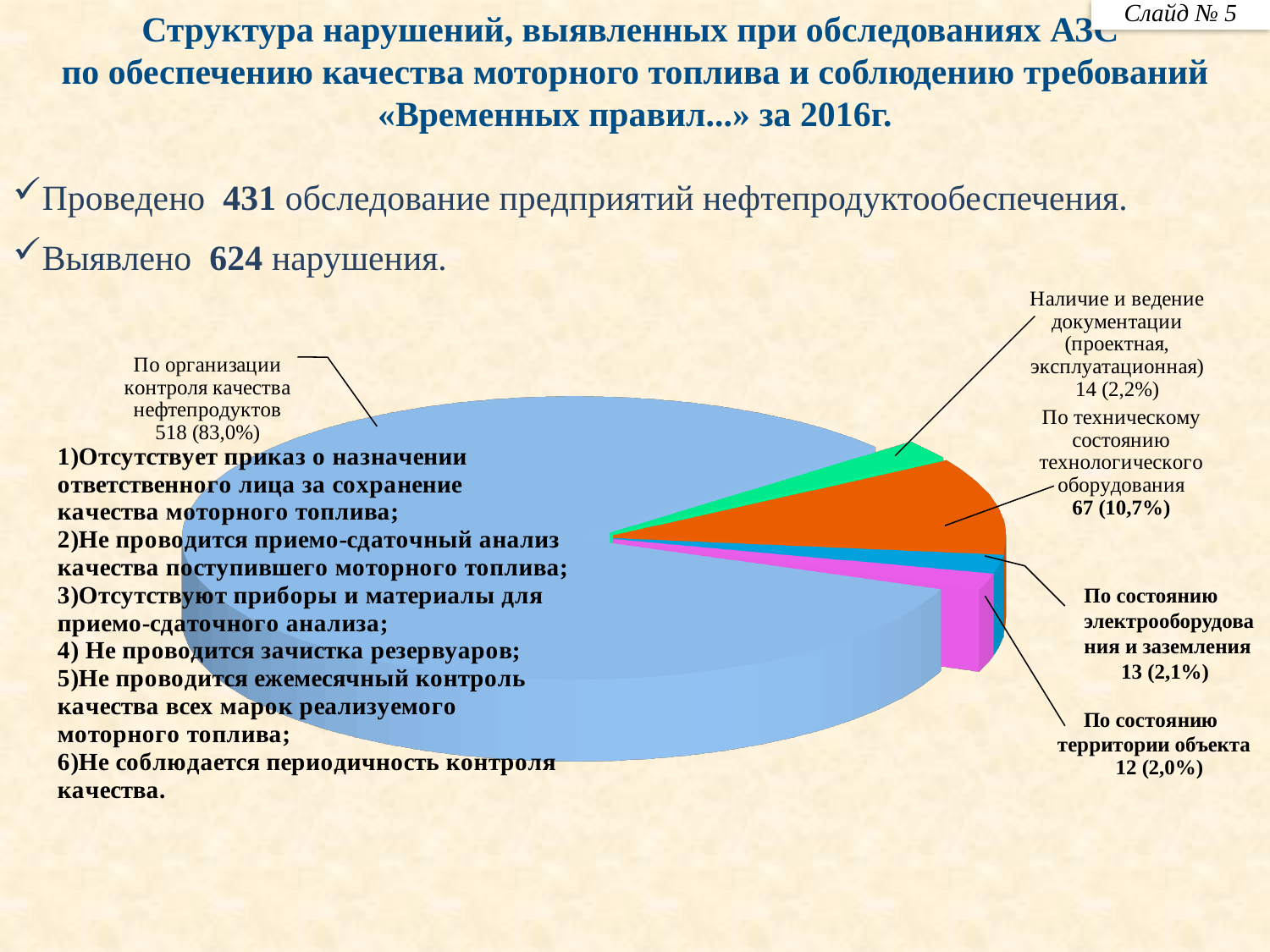
What colour is the slice for "По техническому состоянию технологического оборудования"? orange Which has more violations: "По состоянию электрооборудования и заземления" or "По состоянию территории объекта"? По состоянию электрооборудования и заземления What share of the pie does "По состоянию электрооборудования и заземления" account for? 2,1% How many violations are shown for "Наличие и ведение документации (проектная, эксплуатационная)"? 14 How many slices does the pie chart have? 5 What is the difference between the number of violations for "По организации контроля качества нефтепродуктов" and "По техническому состоянию технологического оборудования"? 451 Which category has the smallest slice of the pie? По состоянию территории объекта How many violations are shown for "По организации контроля качества нефтепродуктов"? 518 How many violations are shown for "По техническому состоянию технологического оборудования"? 67 What kind of chart is shown on the slide? pie chart What share of the pie does "По организации контроля качества нефтепродуктов" account for? 83,0% Which category has the largest slice of the pie? По организации контроля качества нефтепродуктов